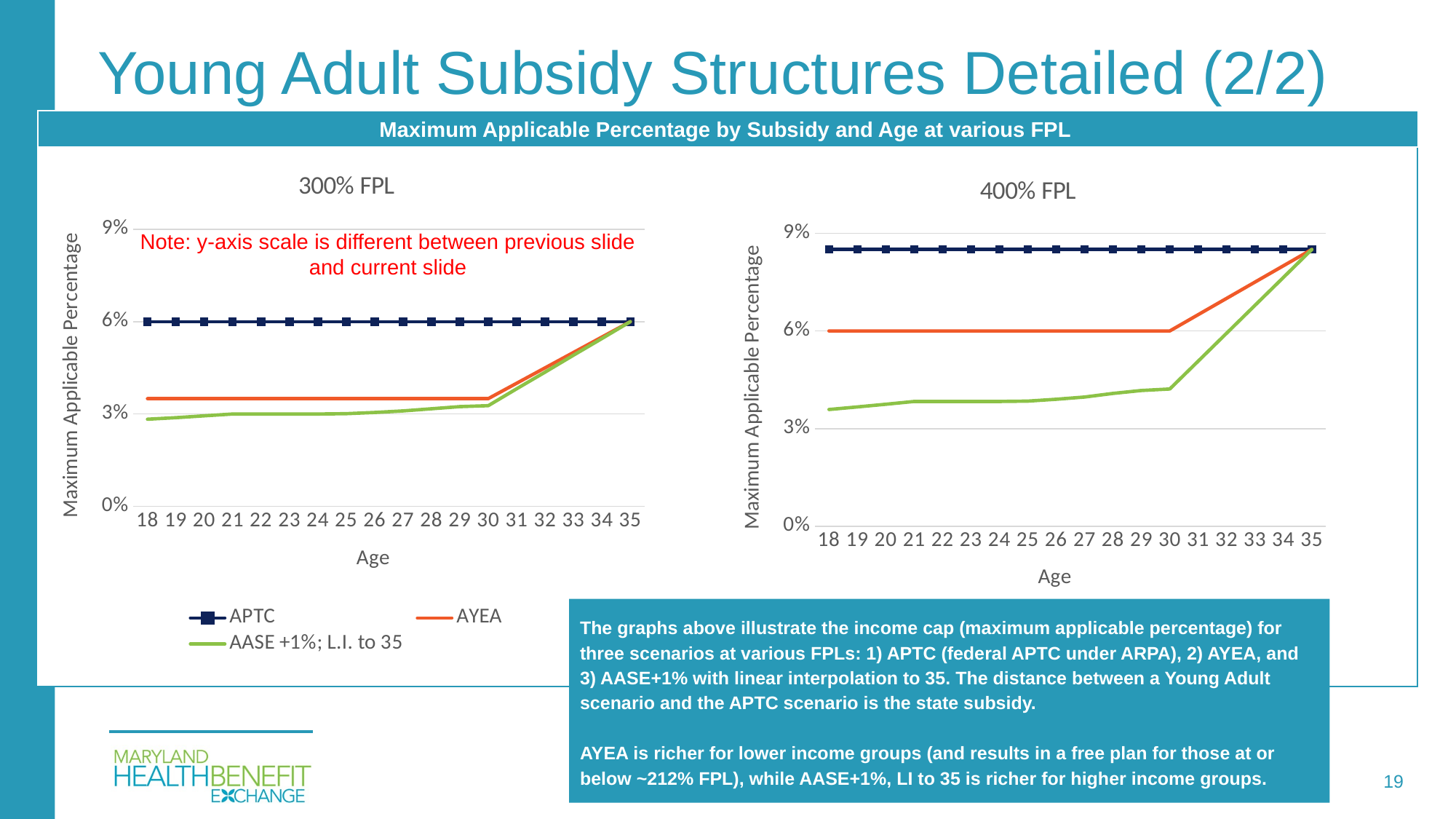
In the 400% FPL chart, does the AASE +1%; L.I. to 35 series rise or fall from age 30 to age 35? rise In the 400% FPL chart, what is the AYEA value at age 22? 6% How many series does the legend list? 3 In the 300% FPL chart, what is the APTC value at age 25? 6% In the 400% FPL chart, is the APTC value at age 20 greater or less than 6%? greater What kind of chart is the 300% FPL chart? line chart What is the overall title shown above the two charts? Maximum Applicable Percentage by Subsidy and Age at various FPL In the 400% FPL chart, which series has the lowest value at age 18? AASE +1%; L.I. to 35 In the 300% FPL chart, is the AASE +1%; L.I. to 35 value at age 18 greater or less than 3%? less How many age points are plotted along the x axis of the 400% FPL chart? 18 In the 400% FPL chart at age 25, which is larger: APTC or AYEA? APTC In the 300% FPL chart, is the AYEA value at age 24 greater or less than 3%? greater